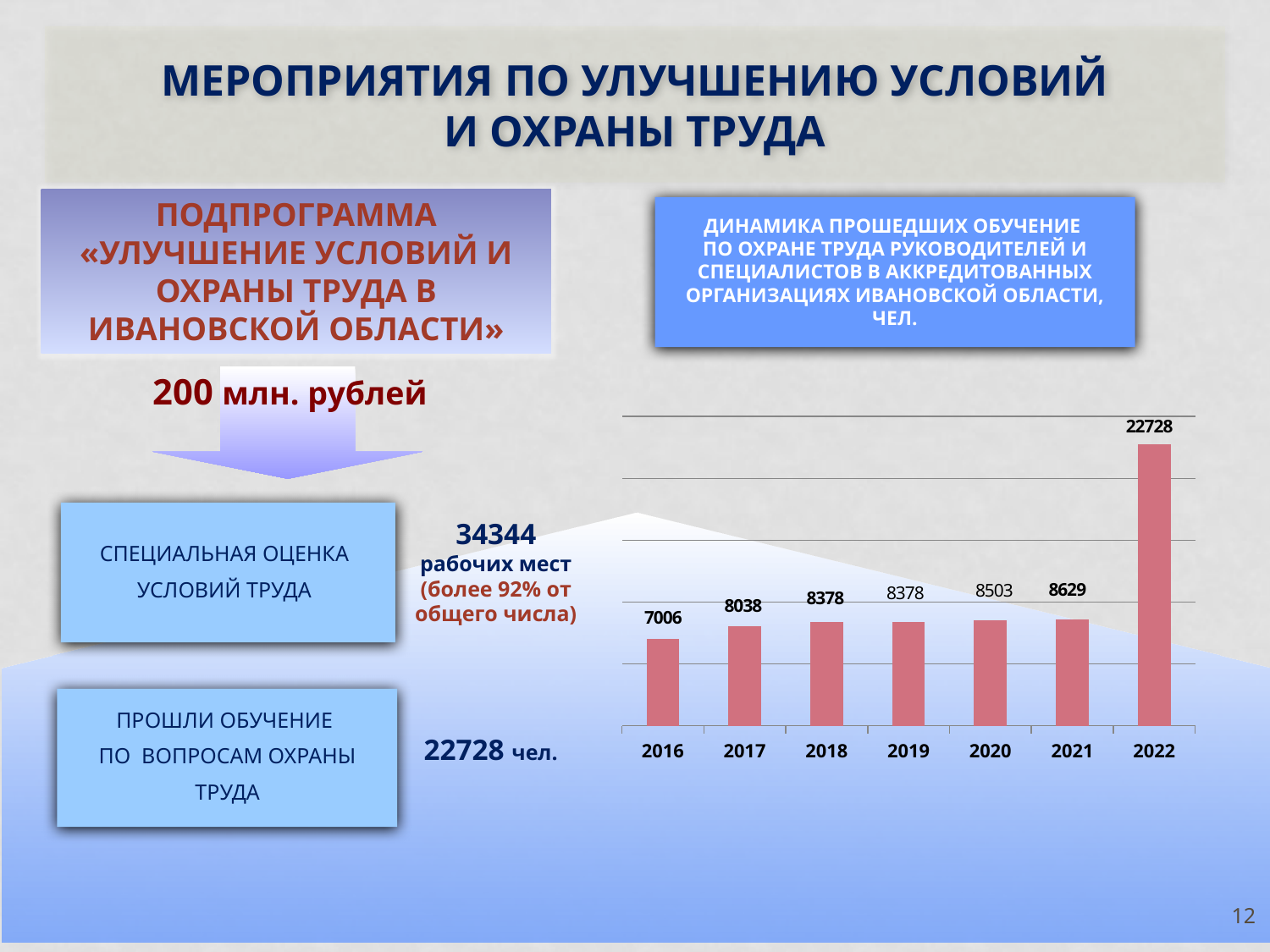
What is the difference between the values for 2022 and 2021? 14099 Which year has the highest value? 2022 What colour are the bars in the chart? red What is the value for 2016? 7006 Which is larger, the value for 2021 or the value for 2020? 2021 What kind of chart is shown on the slide? bar chart Which year has the lowest value? 2016 Do the values rise or fall from 2016 to 2022? rise What is the difference between the values for 2017 and 2016? 1032 What is the value for 2022? 22728 What is the value for 2020? 8503 How many years are shown on the x axis of the chart? 7